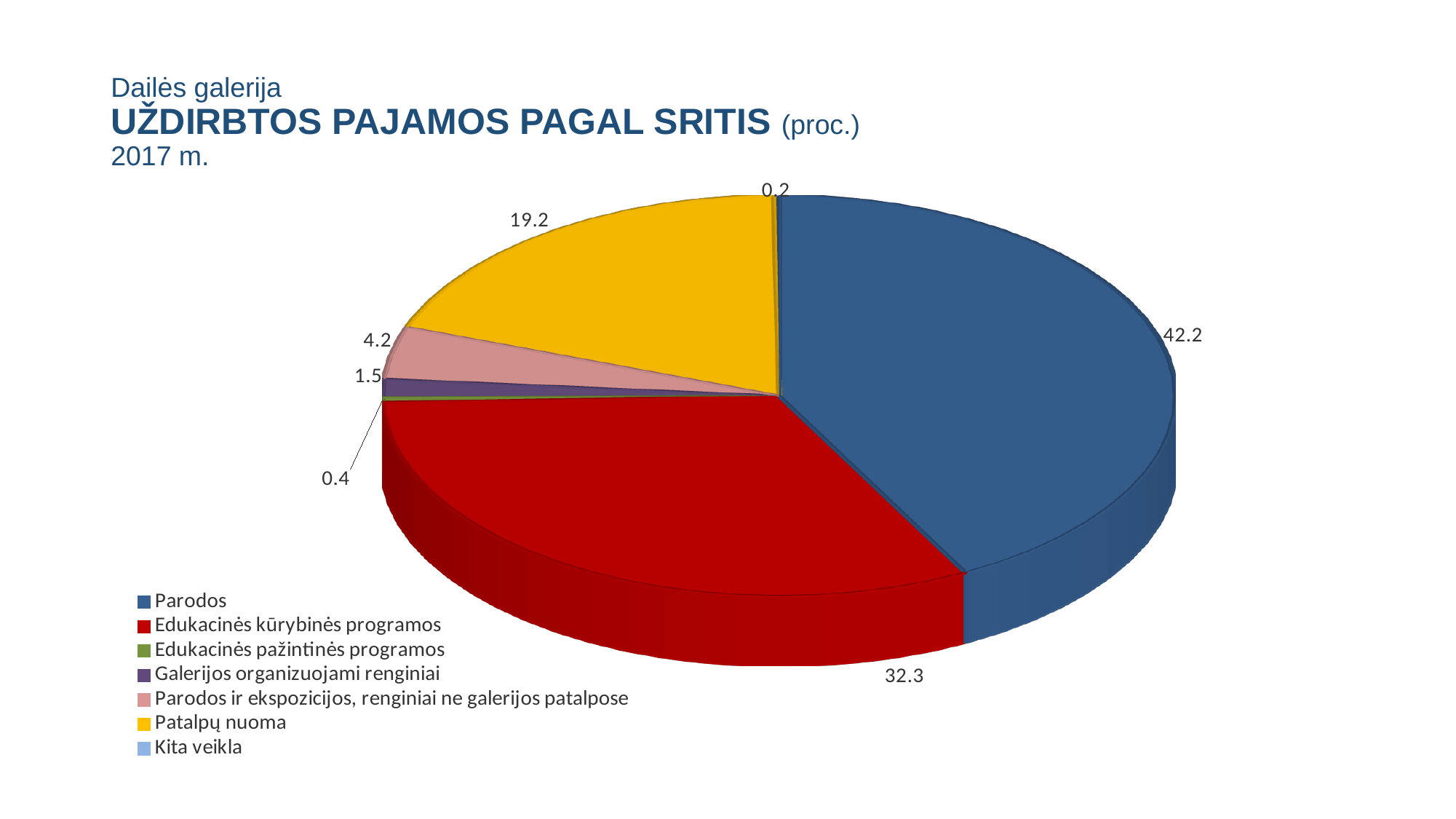
What is the value for Parodos? 42.2 What year does the chart title refer to? 2017 m. What is the value for Patalpų nuoma? 19.2 Which is larger, the value for Patalpų nuoma or the value for Parodos ir ekspozicijos, renginiai ne galerijos patalpose? Patalpų nuoma What is the value for Edukacinės kūrybinės programos? 32.3 What is the difference between the values for Parodos and Edukacinės kūrybinės programos? 9.9 What is the value for Parodos ir ekspozicijos, renginiai ne galerijos patalpose? 4.2 How many categories does the legend list? 7 Which category has the smallest share of the pie? Kita veikla Which category has the largest share of the pie? Parodos What is the value for Galerijos organizuojami renginiai? 1.5 What kind of chart is shown on the slide? pie chart